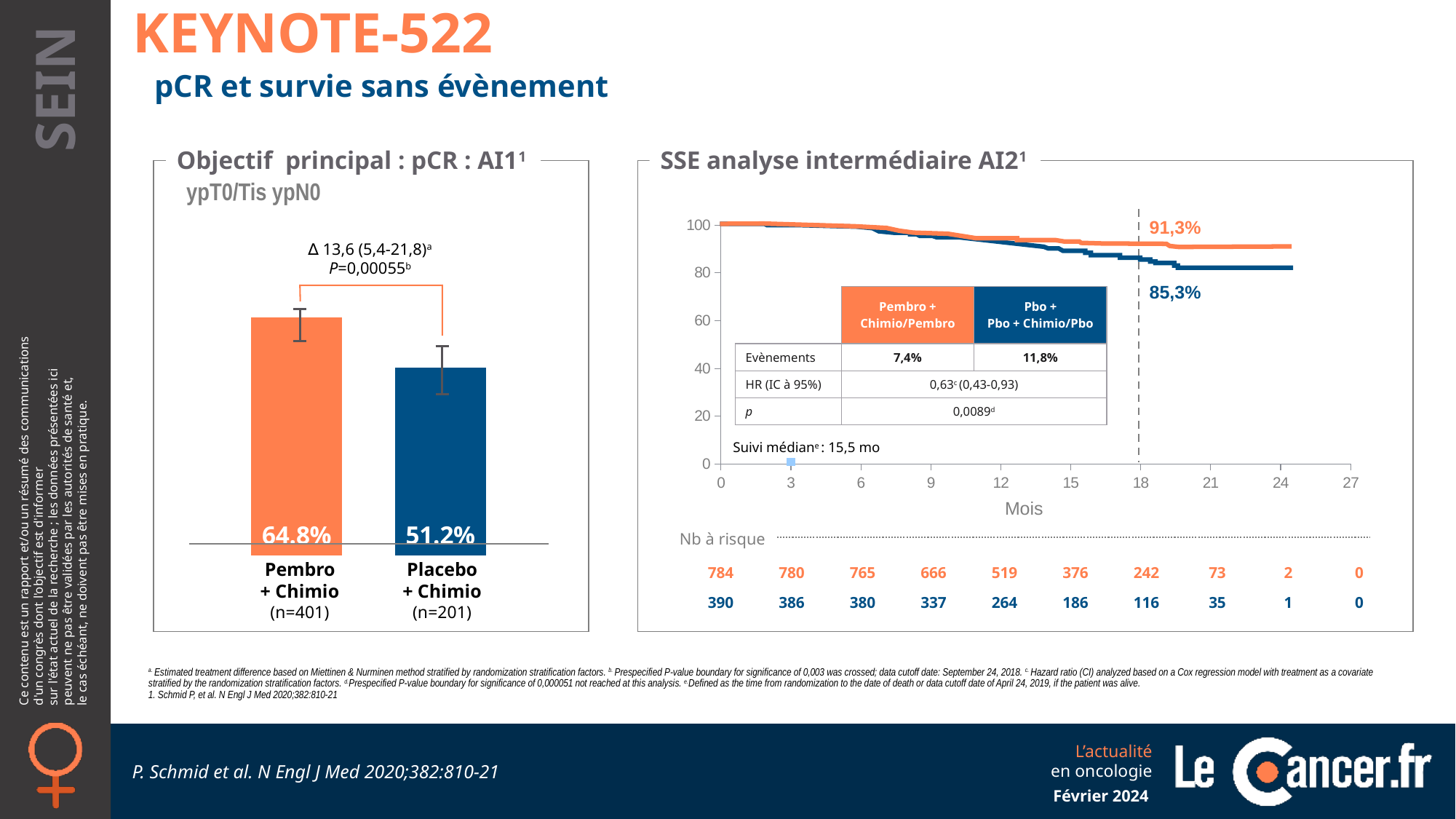
On the right chart (SSE analyse intermédiaire AI2), do the survival curves rise or fall as months increase? fall On the right chart (SSE analyse intermédiaire AI2), what is the event-free survival rate labelled for the Pbo + Chimio/Pbo arm at 18 months? 85,3% On the left chart (Objectif principal : pCR : AI1), what is the difference in pCR rate between Pembro + Chimio and Placebo + Chimio? 13.6% On the left chart (Objectif principal : pCR : AI1), which arm has the higher pCR rate? Pembro + Chimio On the right chart (SSE analyse intermédiaire AI2), which arm has the higher event-free survival rate at 18 months? Pembro + Chimio/Pembro On the left chart (Objectif principal : pCR : AI1), how many bars are plotted? 2 On the left chart (Objectif principal : pCR : AI1), what is the pCR rate for Pembro + Chimio? 64.8% On the left chart (Objectif principal : pCR : AI1), what kind of chart is shown? bar chart On the left chart (Objectif principal : pCR : AI1), what is the pCR rate for Placebo + Chimio? 51.2% On the right chart (SSE analyse intermédiaire AI2), what is the event-free survival rate labelled for the Pembro + Chimio/Pembro arm at 18 months? 91,3% On the right chart (SSE analyse intermédiaire AI2), what kind of chart is shown? line chart On the right chart (SSE analyse intermédiaire AI2), how many patients were at risk at month 0 in the Pembro + Chimio/Pembro arm? 784